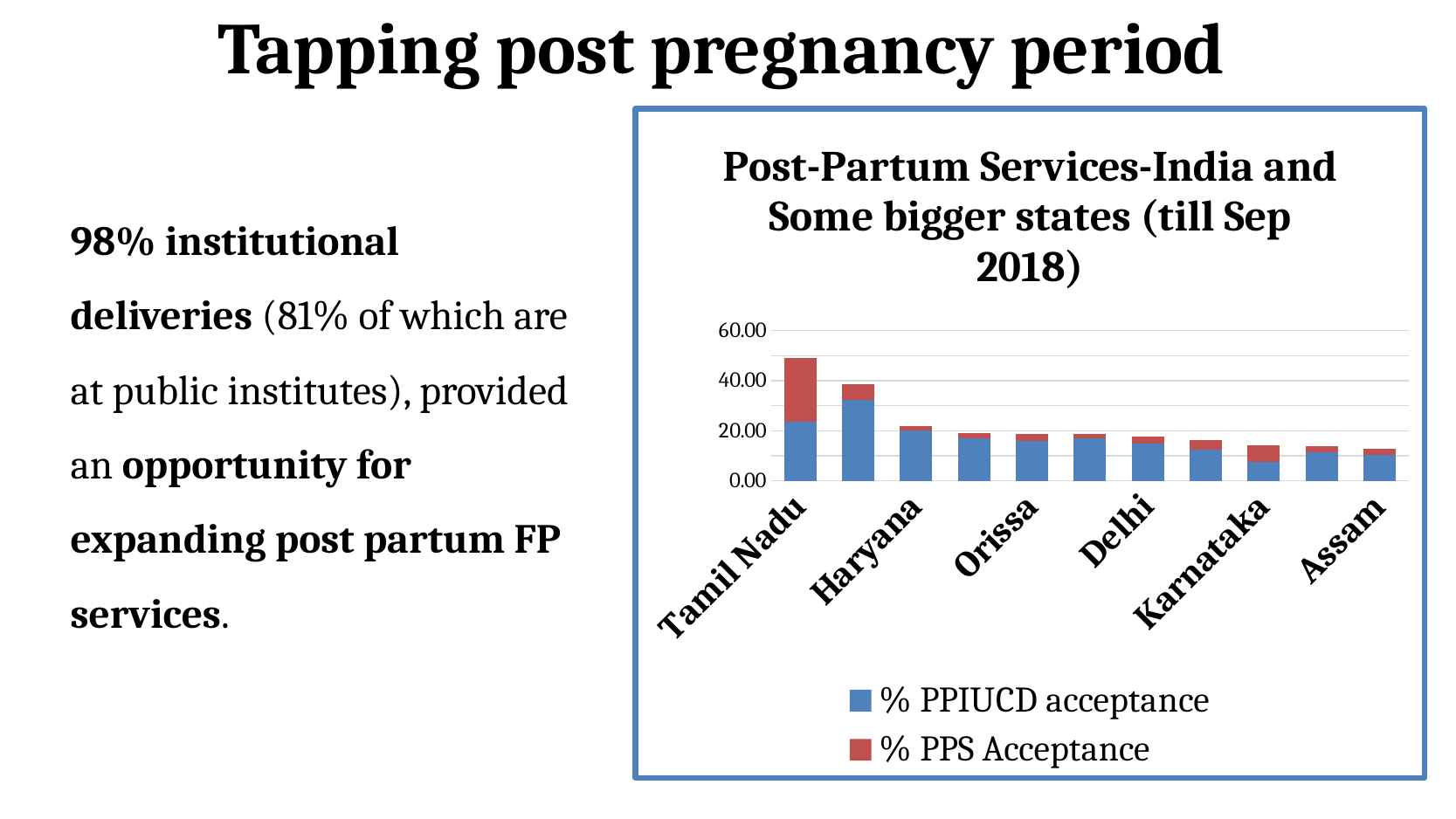
What kind of chart is shown on the slide? Stacked bar chart Do the total bar heights generally rise or fall from left to right across the states? fall Is the % PPIUCD acceptance value for Tamil Nadu greater or less than 20.00? greater Is the total bar for Assam greater or less than 20.00? less What is the title of the chart? Post-Partum Services-India and Some bigger states (till Sep 2018) Which state has the highest total bar in the chart? Tamil Nadu How many series does the chart legend list? 2 Is the total bar for Haryana greater or less than 40.00? less Which series is shown in red in the chart? % PPS Acceptance Which state has the larger % PPIUCD acceptance (blue segment), Tamil Nadu or Haryana? Tamil Nadu Among the labelled states, which has the lowest total bar? Assam